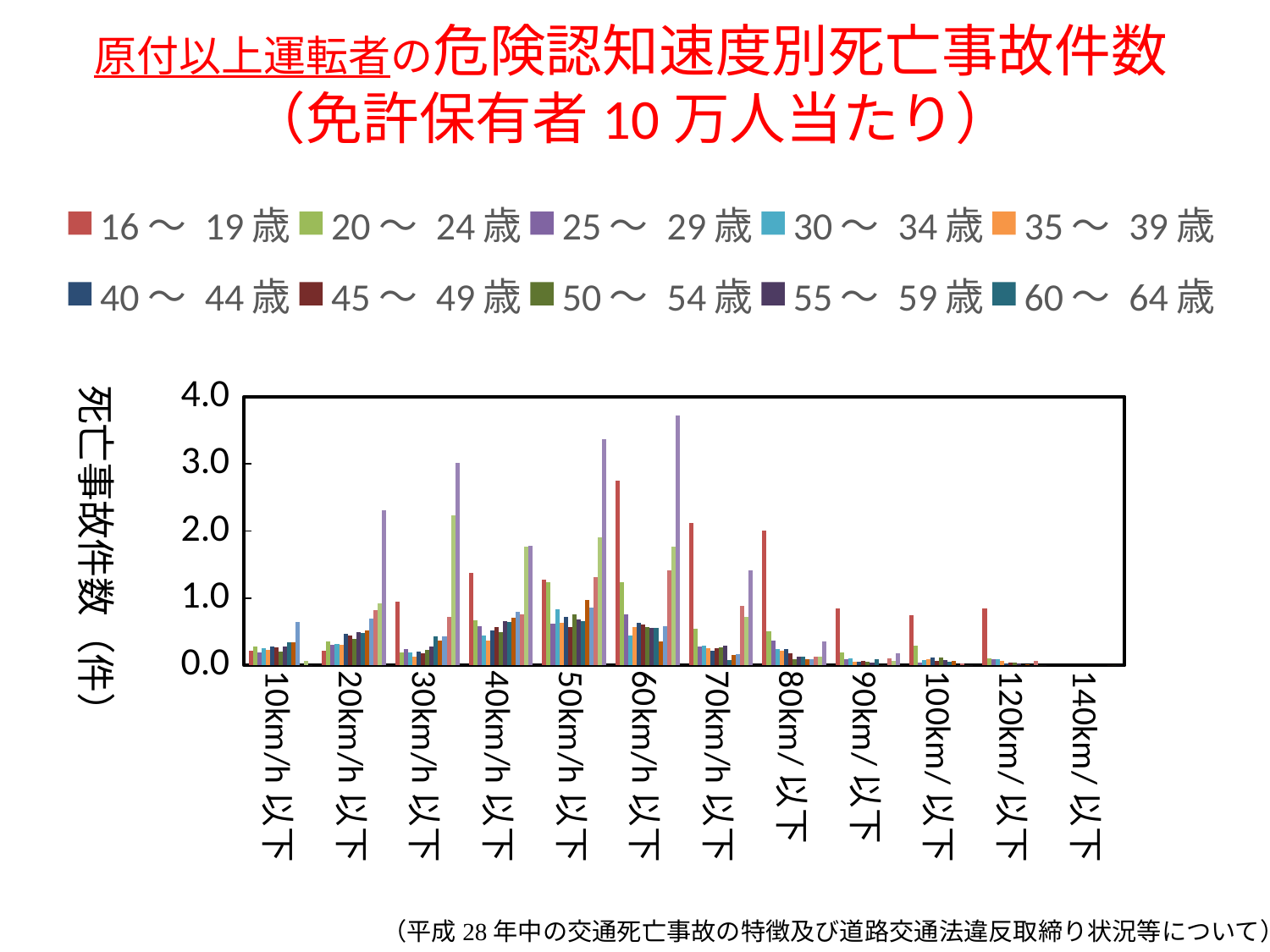
Is the value for 16～19歳 at 60km/h以下 greater or less than 2.0? greater Is the value for 16～19歳 at 120km/以下 greater or less than 1.0? less How many speed categories are shown along the x axis? 12 What kind of chart is shown on the slide? bar chart Which age group is represented by the purple bars in the legend? 25～29歳 What is the highest tick value shown on the y axis? 4.0 Which speed category contains the tallest bar in the chart? 60km/h以下 How many age-group series does the legend list? 10